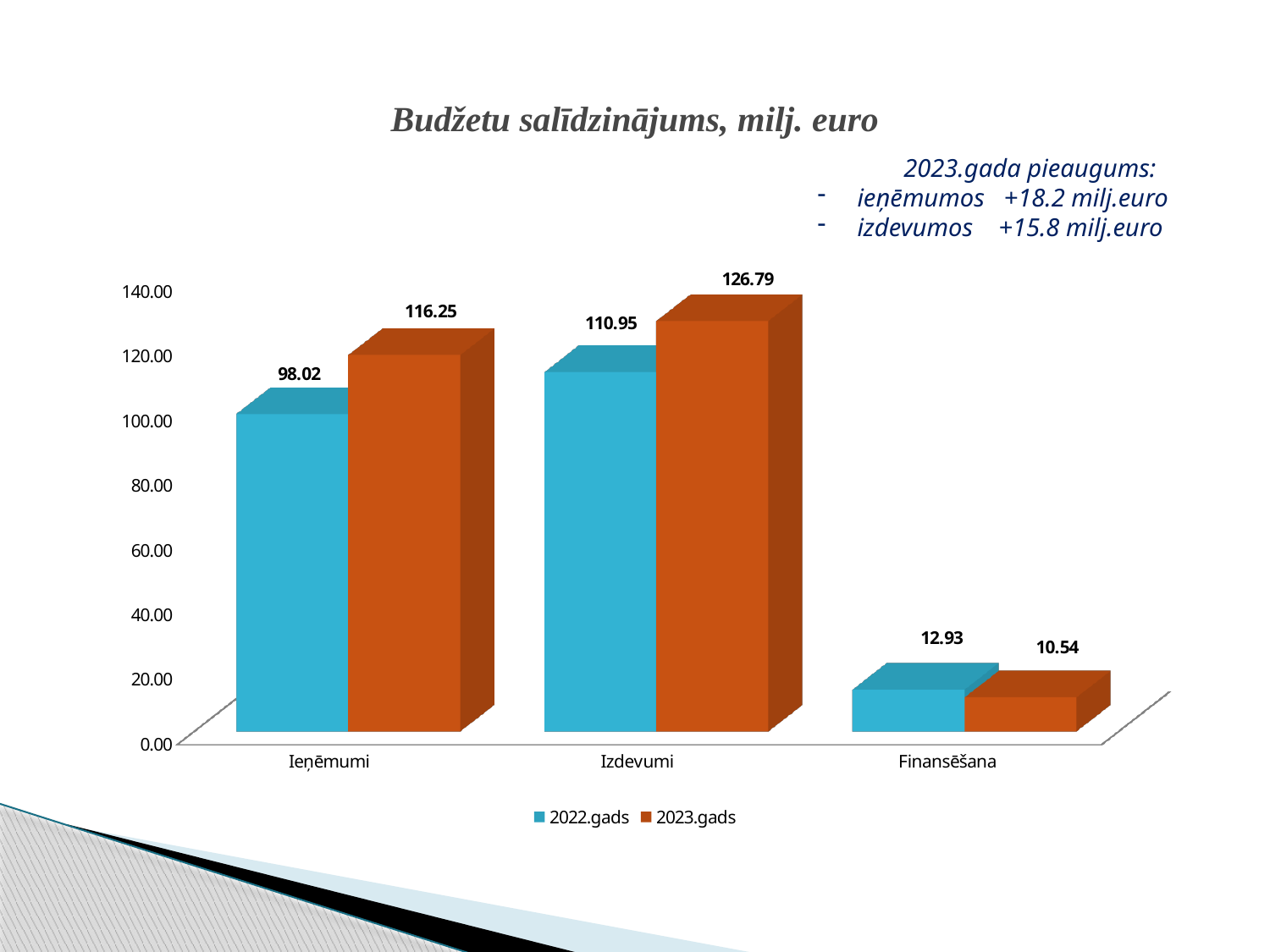
What is the value for Finansēšana in 2022.gads? 12.93 Is the 2022.gads value for Izdevumi greater or less than 100.00? greater What kind of chart is shown on the slide? bar chart What is the value for Ieņēmumi in 2022.gads? 98.02 How many categories are shown on the x axis? 3 Which is larger for Finansēšana: the 2022.gads value or the 2023.gads value? 2022.gads How many series does the legend list? 2 What is the difference between the 2023.gads and 2022.gads values for Ieņēmumi? 18.23 Which category has the lowest value in the 2022.gads series? Finansēšana Which category has the highest value in the 2023.gads series? Izdevumi What is the title of the chart? Budžetu salīdzinājums, milj. euro What is the value for Izdevumi in 2023.gads? 126.79